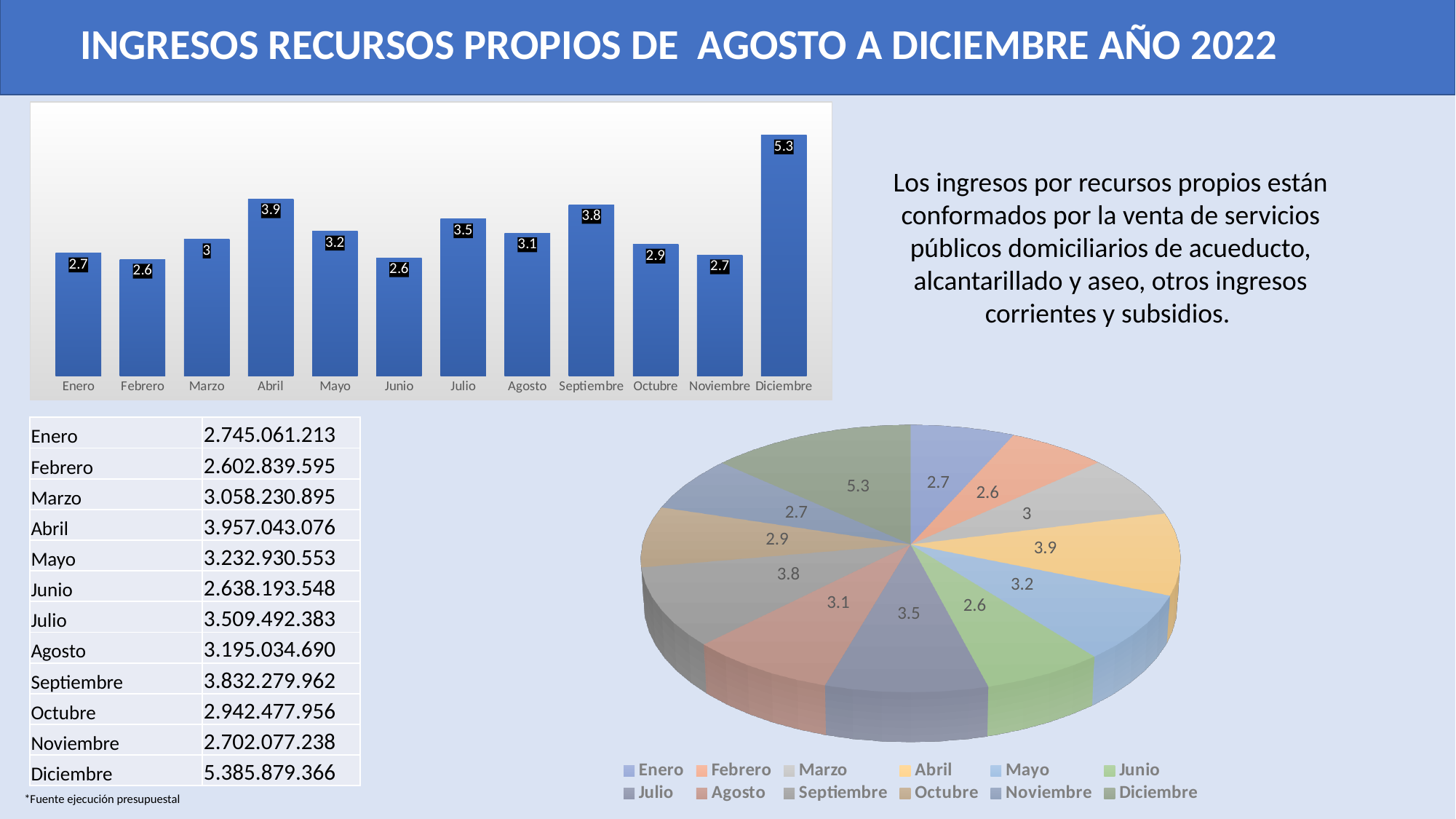
In the bar chart at the top left, which month has the highest value? Diciembre In the bar chart at the top left, which is larger, the value for Julio or the value for Mayo? Julio How many entries does the legend of the pie chart at the bottom right list? 12 In the bar chart at the top left, what is the difference between the values for Diciembre and Abril? 1.4 In the bar chart at the top left, do the values rise or fall from Abril to Junio? Fall How many bars are shown in the bar chart at the top left? 12 In the pie chart at the bottom right, which slice has the largest value? Diciembre What kind of chart is shown at the bottom right of the slide? Pie chart What kind of chart is shown at the top left of the slide? Bar chart In the bar chart at the top left, what is the value for Diciembre? 5.3 In the bar chart at the top left, what is the value for Abril? 3.9 In the pie chart at the bottom right, what is the value labelled on the Septiembre slice? 3.8